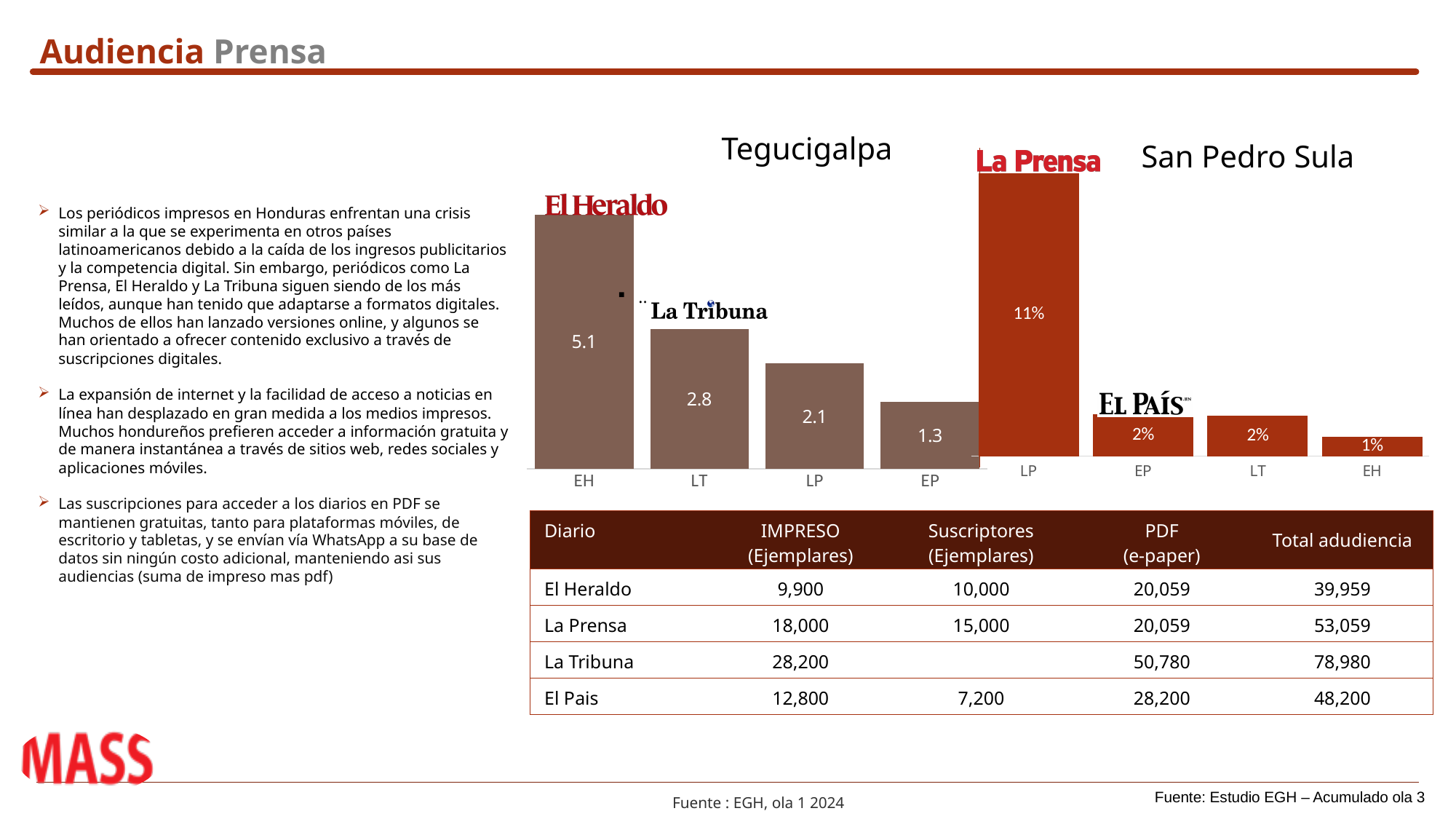
In the Tegucigalpa chart, do the values rise or fall from left to right? fall In the Tegucigalpa chart, which category has the highest value? EH In the San Pedro Sula chart, what is the value for LP? 11% In the Tegucigalpa chart, what is the difference between the values for EH and LT? 2.3 In the Tegucigalpa chart, how many categories are shown? 4 In the Tegucigalpa chart, what is the value for LP? 2.1 In the Tegucigalpa chart, which category has the lowest value? EP In the Tegucigalpa chart, what is the value for EH? 5.1 In the San Pedro Sula chart, what is the value for EH? 1% In the San Pedro Sula chart, which category has the highest value? LP What kind of chart is the San Pedro Sula chart? bar chart In the San Pedro Sula chart, what is the difference between the values for LP and EP? 9%